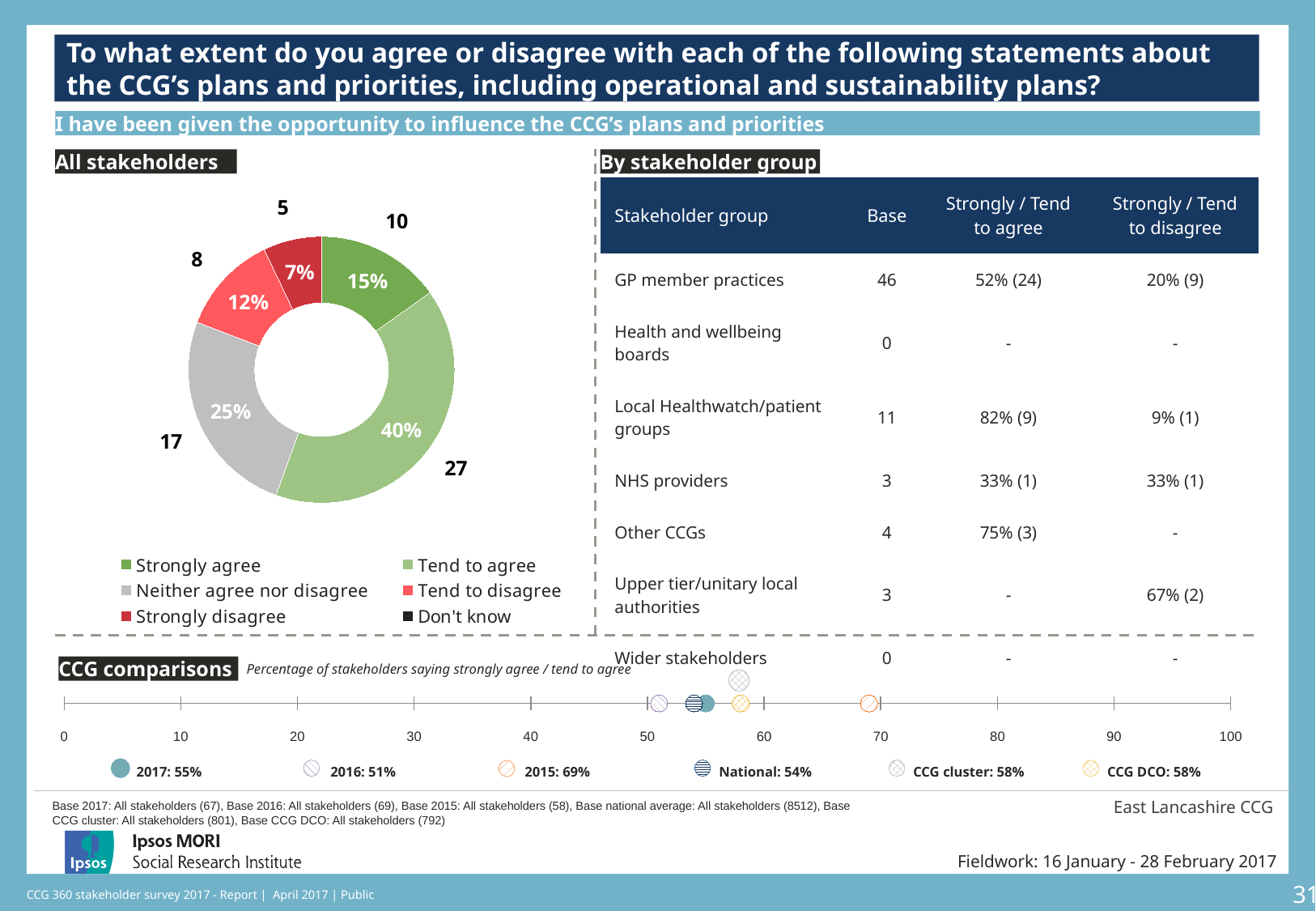
In the 'All stakeholders' donut chart, what percentage of stakeholders said 'Strongly disagree'? 7% In the 'All stakeholders' donut chart, what is the difference in percentage points between 'Neither agree nor disagree' and 'Tend to disagree'? 13 In the 'CCG comparisons' chart, what is the difference in percentage points between the 2017 value and the 2016 value? 4 What type of chart is used for the 'All stakeholders' section? Donut (pie) chart In the 'All stakeholders' donut chart, what percentage of stakeholders said 'Tend to agree'? 40% In the 'All stakeholders' donut chart, which response category has the largest share? Tend to agree In the 'All stakeholders' donut chart, which is larger: the share for 'Strongly agree' or the share for 'Tend to disagree'? Strongly agree In the 'All stakeholders' donut chart, which labelled response category has the smallest share? Strongly disagree In the 'CCG comparisons' chart, what percentage of stakeholders said strongly agree / tend to agree in 2017? 55% In the 'CCG comparisons' chart, which comparison point has the highest value? 2015: 69% How many entries does the legend of the 'All stakeholders' donut chart list? 6 In the 'All stakeholders' donut chart, how many respondents does the 'Tend to agree' segment represent? 27